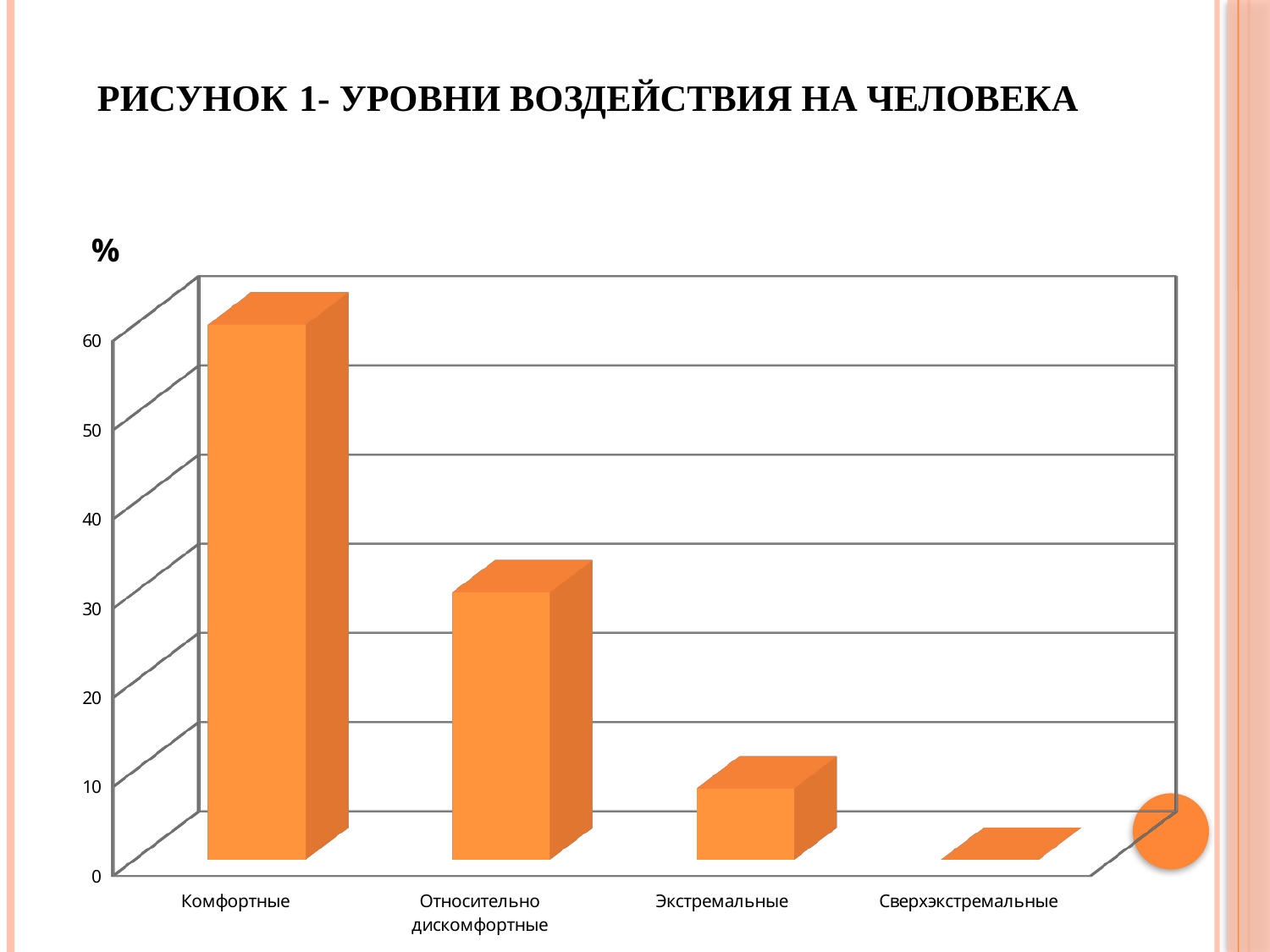
What unit is shown on the vertical axis label of the chart? % Do the values rise or fall moving from left to right along the x axis? fall Is the value for Относительно дискомфортные greater or less than 40? less How many categories are shown on the x axis of the chart? 4 Which is larger, the value for Относительно дискомфортные or the value for Экстремальные? Относительно дискомфортные Is the value for Экстремальные greater or less than 20? less Is the value for Относительно дискомфортные greater or less than 20? greater Which category has the highest value in the chart? Комфортные What kind of chart is shown on the slide? bar chart Which category has the lowest value in the chart? Сверхэкстремальные